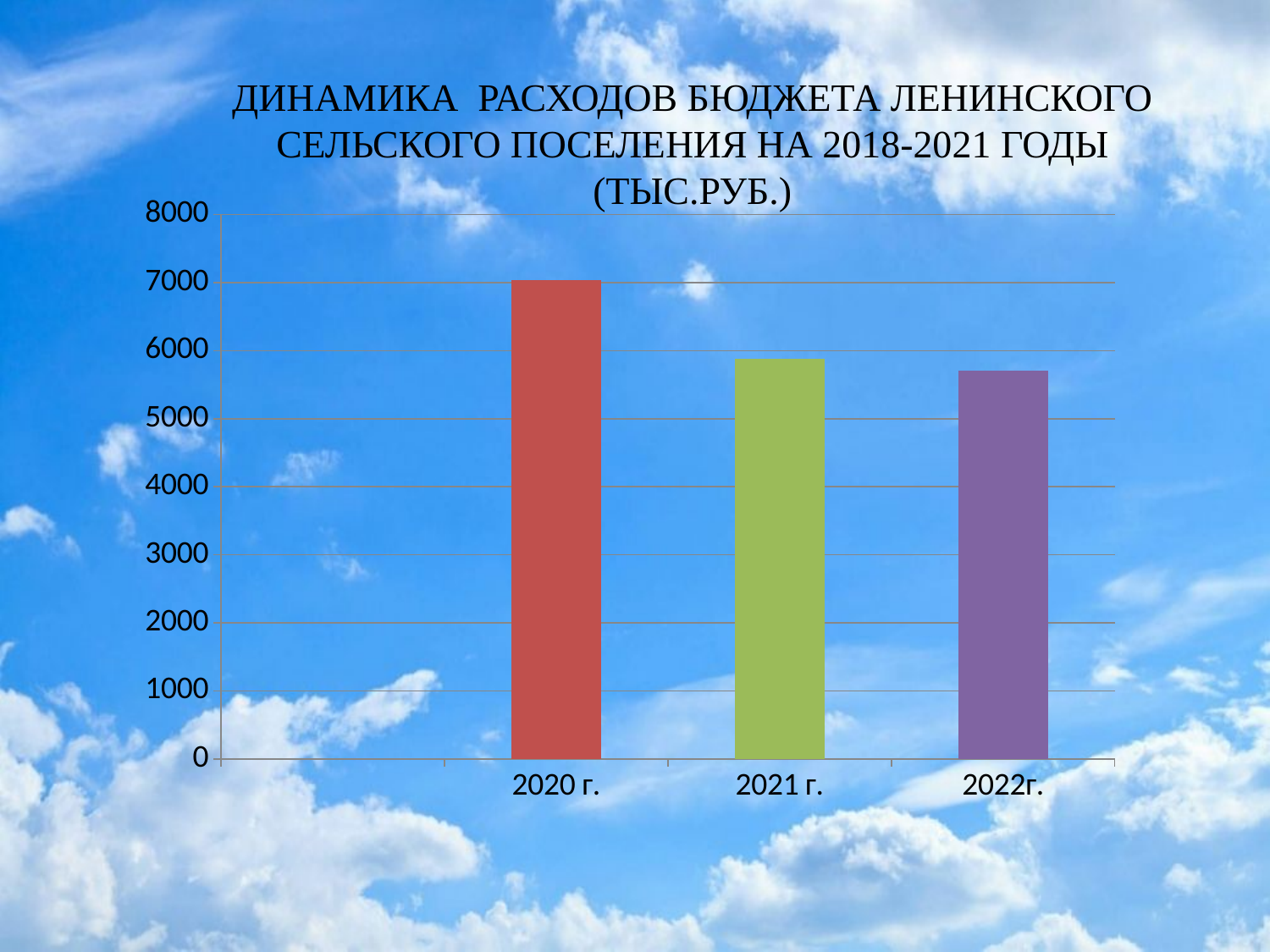
What kind of chart is shown on the slide? bar chart Is the value for 2022г. greater or less than 7000? less Which is larger, the value for 2020 г. or the value for 2022г.? 2020 г. Is the value for 2021 г. greater or less than 5000? greater Is the value for 2022г. greater or less than 6000? less Which year has the highest budget expenditure on the chart? 2020 г. How many years (categories) are plotted on the chart? 3 Do the values rise or fall from 2020 to 2022 along the x axis? fall Which is larger, the value for 2020 г. or the value for 2021 г.? 2020 г. What colour is the bar for 2020 г.? red Which year has the lowest budget expenditure on the chart? 2022г.